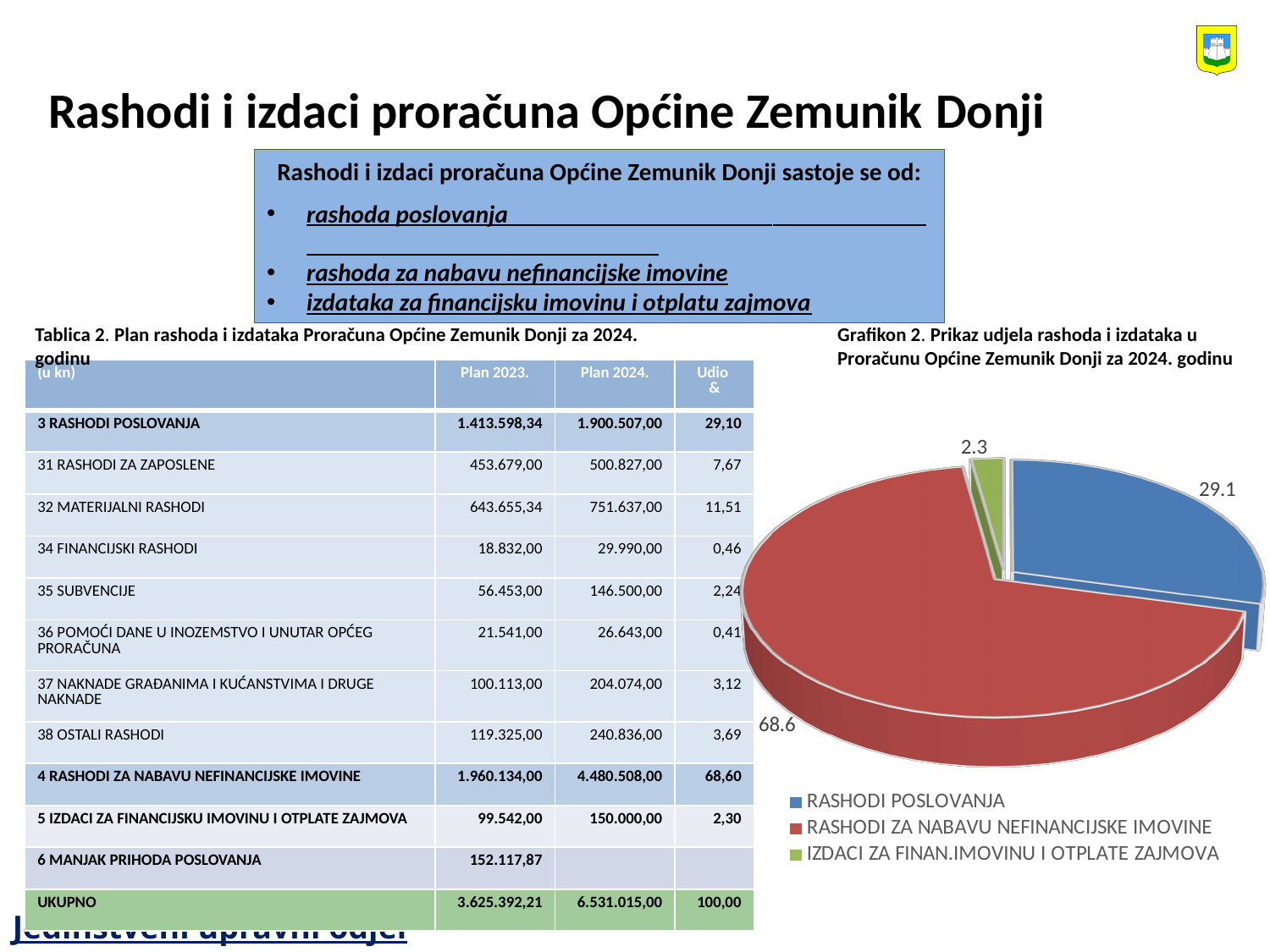
In the pie chart, what is the value shown for RASHODI ZA NABAVU NEFINANCIJSKE IMOVINE? 68.6 In the pie chart, what is the value shown for RASHODI POSLOVANJA? 29.1 Which category has the largest slice in the pie chart? RASHODI ZA NABAVU NEFINANCIJSKE IMOVINE How many entries does the legend of the pie chart list? 3 In the pie chart, what is the difference between the values for RASHODI ZA NABAVU NEFINANCIJSKE IMOVINE and RASHODI POSLOVANJA? 39.5 In the pie chart, what is the value shown for IZDACI ZA FINAN.IMOVINU I OTPLATE ZAJMOVA? 2.3 Which category has the smallest slice in the pie chart? IZDACI ZA FINAN.IMOVINU I OTPLATE ZAJMOVA What is the title of the pie chart on the slide? Grafikon 2. Prikaz udjela rashoda i izdataka u Proračunu Općine Zemunik Donji za 2024. godinu In the pie chart, which is larger: RASHODI POSLOVANJA or IZDACI ZA FINAN.IMOVINU I OTPLATE ZAJMOVA? RASHODI POSLOVANJA What type of chart is Grafikon 2 on the slide? Pie chart What colour is the slice for RASHODI ZA NABAVU NEFINANCIJSKE IMOVINE in the pie chart? Red How many slices does the pie chart have? 3